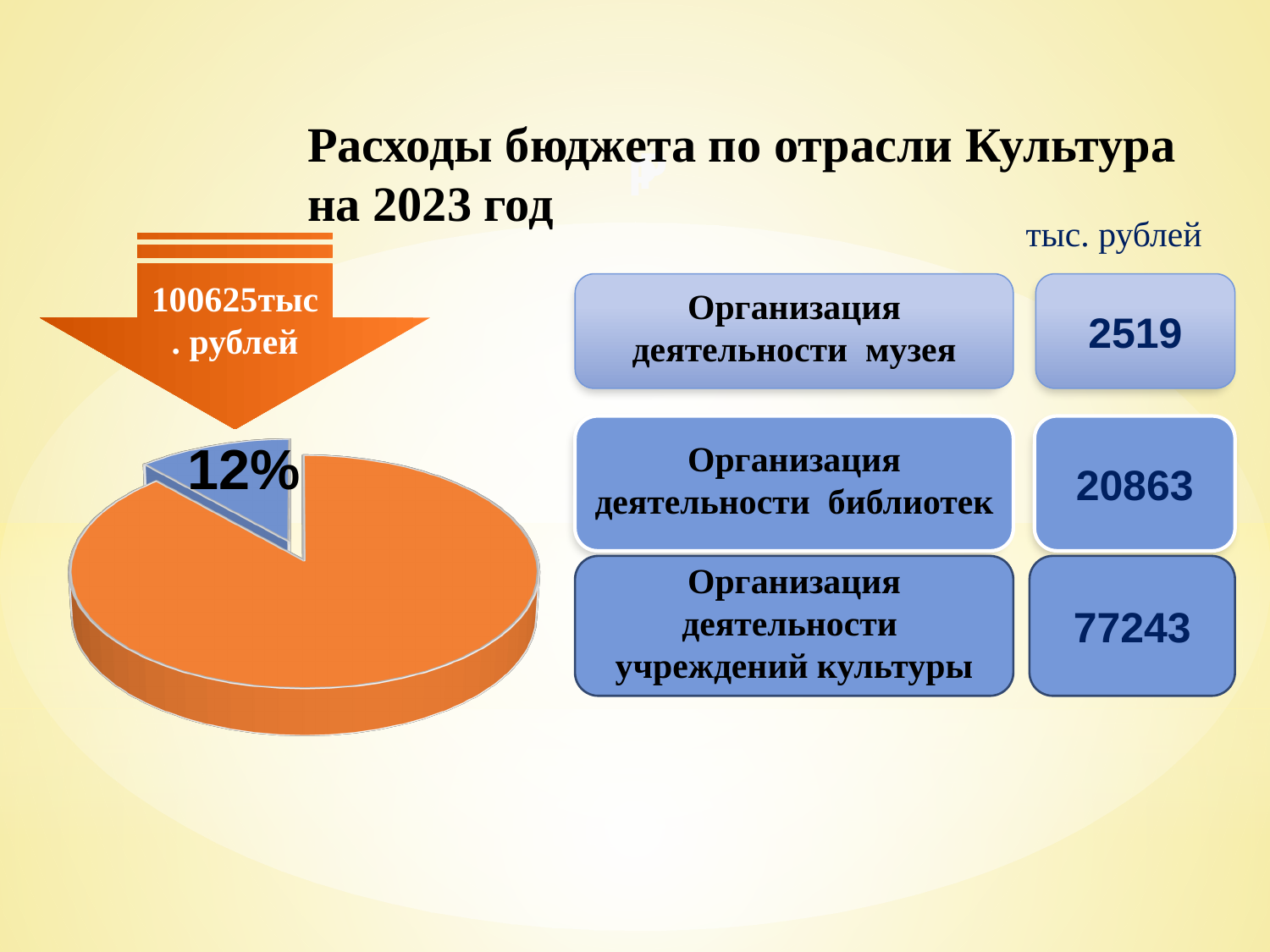
What is the title shown above the chart on the slide? Расходы бюджета по отрасли Культура на 2023 год Which slice of the pie chart is the largest? the orange slice How many slices does the pie chart have? 2 What share of the pie does the blue slice represent? 12% Which slice of the pie chart is the smallest? the blue slice (12%) What kind of chart is shown on the slide? pie chart Which is larger in the pie chart, the orange slice or the blue slice? the orange slice What colour is the slice labelled 12%? blue